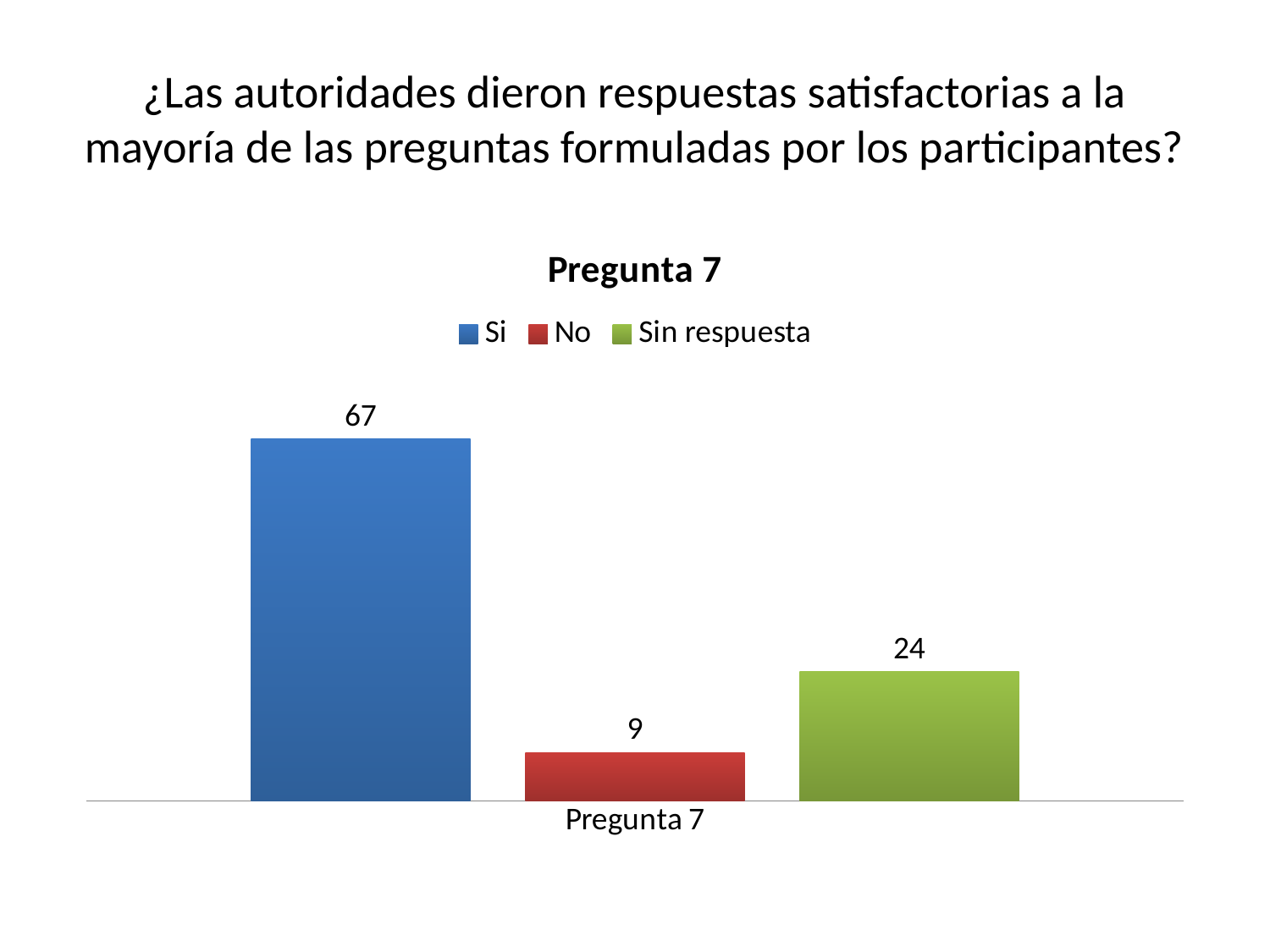
What is the value for Sin respuesta? 24 What colour is the bar for Sin respuesta? green How many series does the legend list? 3 What is the difference between the values for Si and Sin respuesta? 43 Which is larger, the value for No or the value for Sin respuesta? Sin respuesta What is the difference between the values for Sin respuesta and No? 15 What kind of chart is shown? bar chart What is the title of the chart? Pregunta 7 Which series has the lowest value? No What is the value for Si? 67 Which series has the highest value? Si What is the value for No? 9